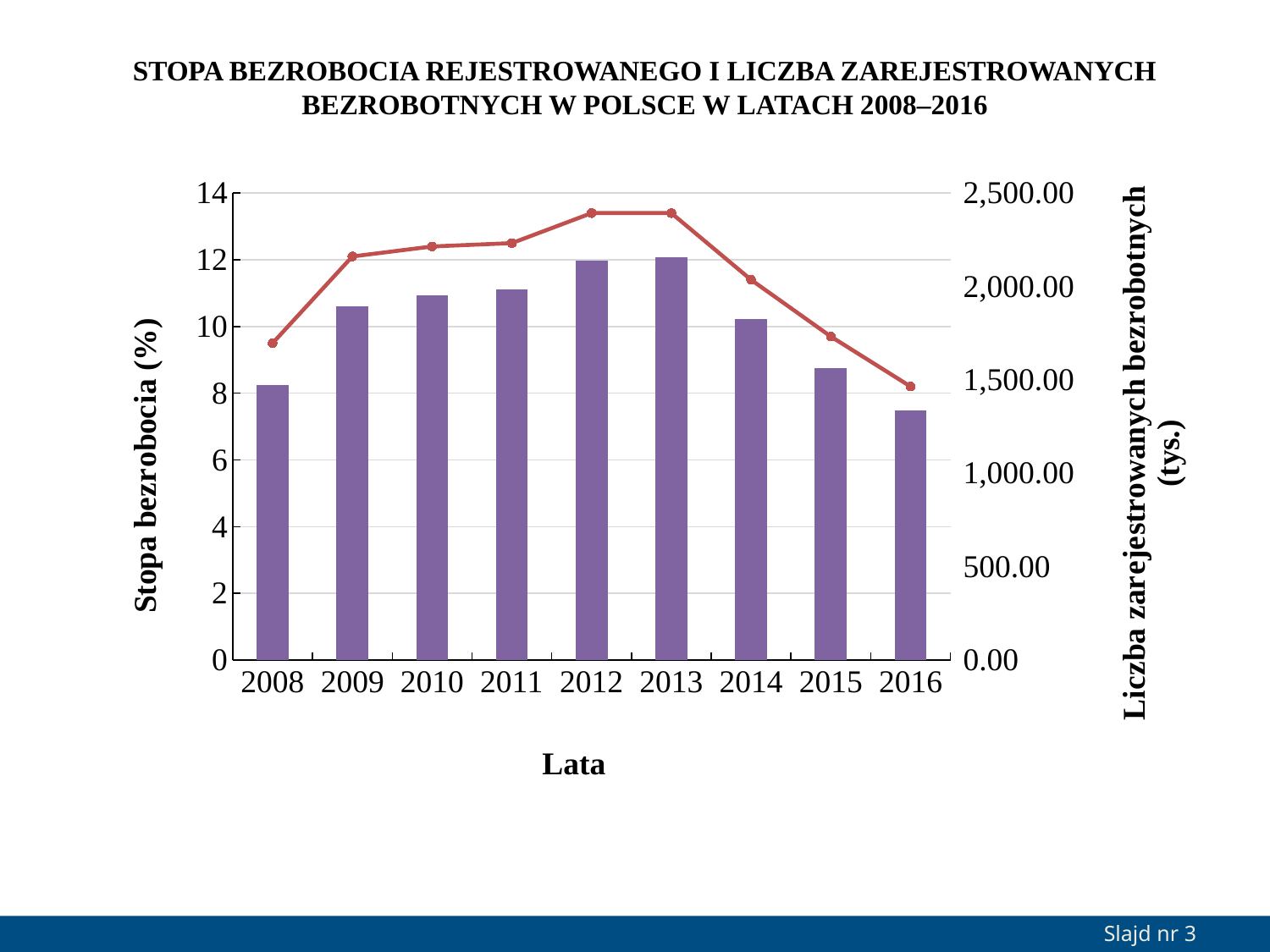
Is the bar value for 2011 greater or less than 10? greater Which year has the taller bar, 2009 or 2015? 2009 What is the label of the x axis? Lata Which year has the lowest bar (Stopa bezrobocia)? 2016 How many years are shown on the x axis of the chart? 9 What kind of chart is shown on the slide? A combined bar and line chart How do the bar values change from 2013 to 2016? They fall each year Is the bar value for 2016 greater or less than 8? less In which year is the line (Liczba zarejestrowanych bezrobotnych) at its lowest point? 2016 Is the line value for 2012 greater or less than 2,000.00? greater